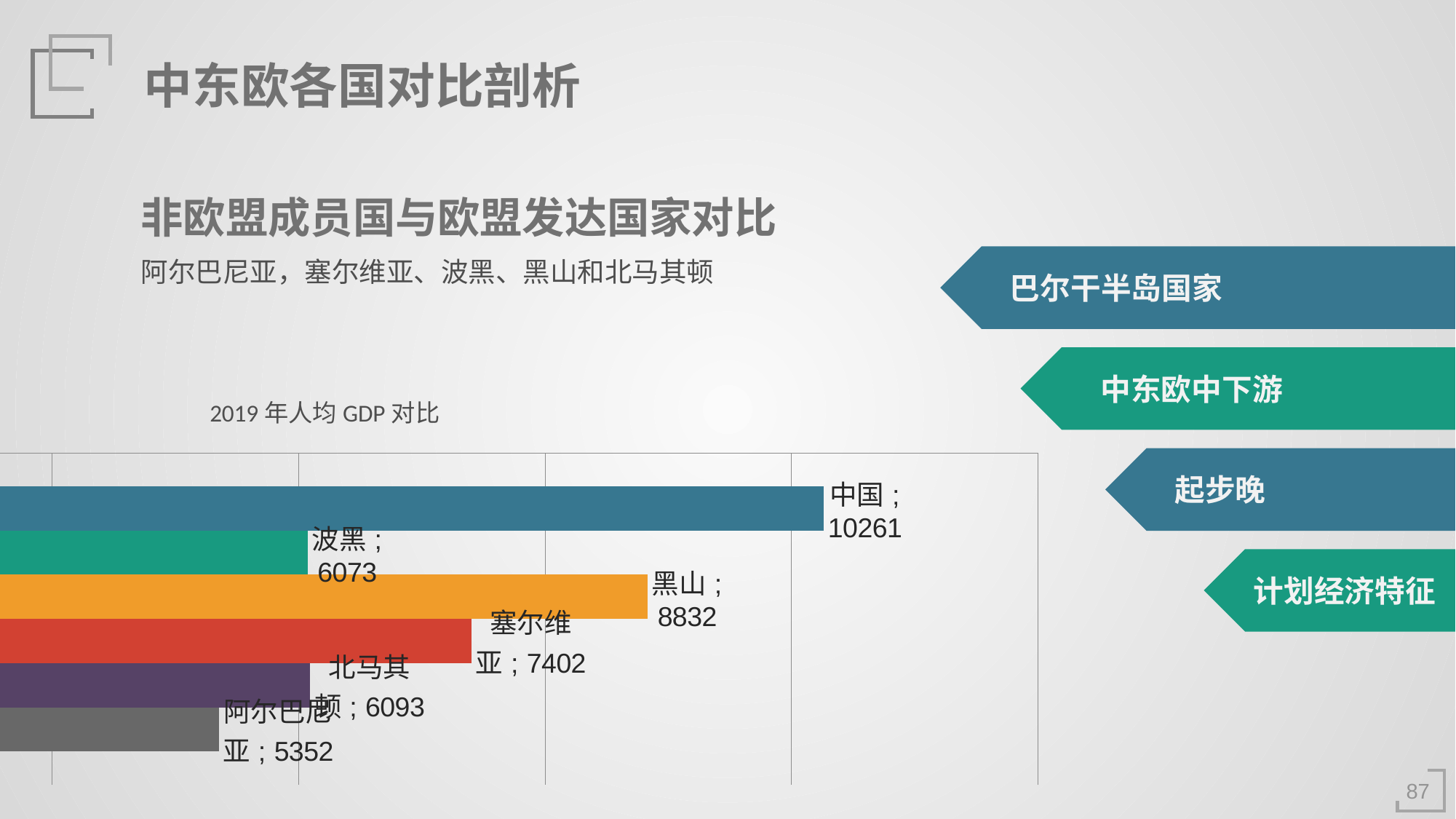
What is the difference between the values for 黑山 and 塞尔维亚? 1430 What kind of chart is shown on the slide? bar chart What is the value for 黑山 in the chart? 8832 What is the value for 中国 in the chart? 10261 What is the value for 塞尔维亚 in the chart? 7402 How many countries are plotted in the chart? 6 What is the value for 阿尔巴尼亚 in the chart? 5352 Which country has the highest value in the chart? 中国 Which is larger, the value for 塞尔维亚 or the value for 波黑? 塞尔维亚 Which country has the lowest value in the chart? 阿尔巴尼亚 What is the difference between the values for 中国 and 黑山? 1429 What is the title of the chart? 2019 年人均 GDP 对比